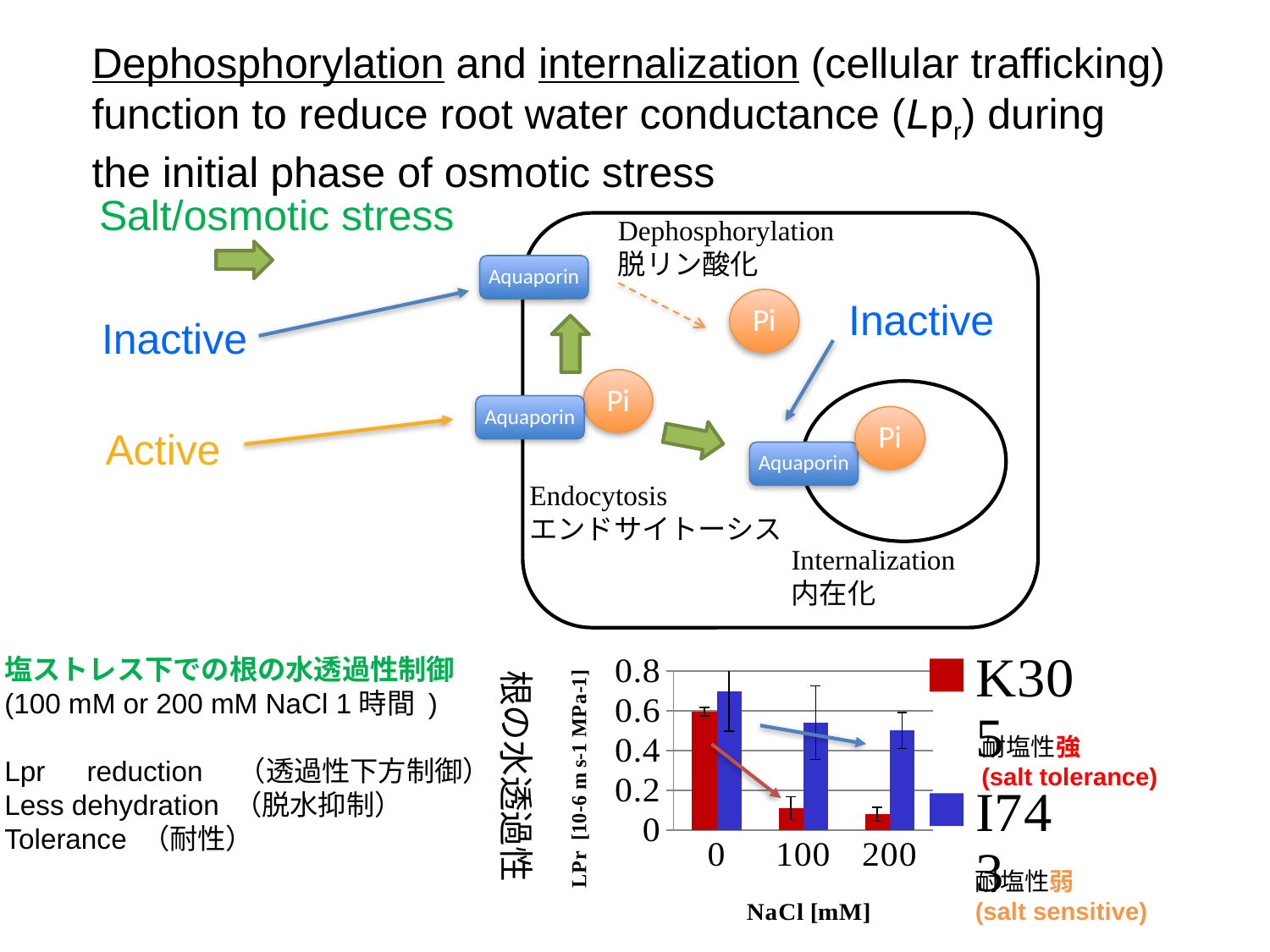
What kind of chart is shown at the bottom of the slide? bar chart Which colour represents the K305 series in the bar chart? red How many NaCl concentration categories are shown on the x axis of the bar chart? 3 In the bar chart, at which NaCl concentration is the red (K305) bar highest? 0 In the bar chart, at which NaCl concentration is the blue (I743) bar highest? 0 How many series does the legend of the bar chart list? 2 In the bar chart, at 100 mM NaCl, which series has the larger value, red (K305) or blue (I743)? blue (I743) Is the value of the blue (I743) bar at 200 mM NaCl greater or less than 0.4? greater What is the x-axis title of the bar chart? NaCl [mM] Is the value of the red (K305) bar at 100 mM NaCl greater or less than 0.2? less In the bar chart, at which NaCl concentration is the red (K305) bar lowest? 200 Do the red (K305) bar values rise or fall as NaCl concentration increases from 0 to 200 mM? fall